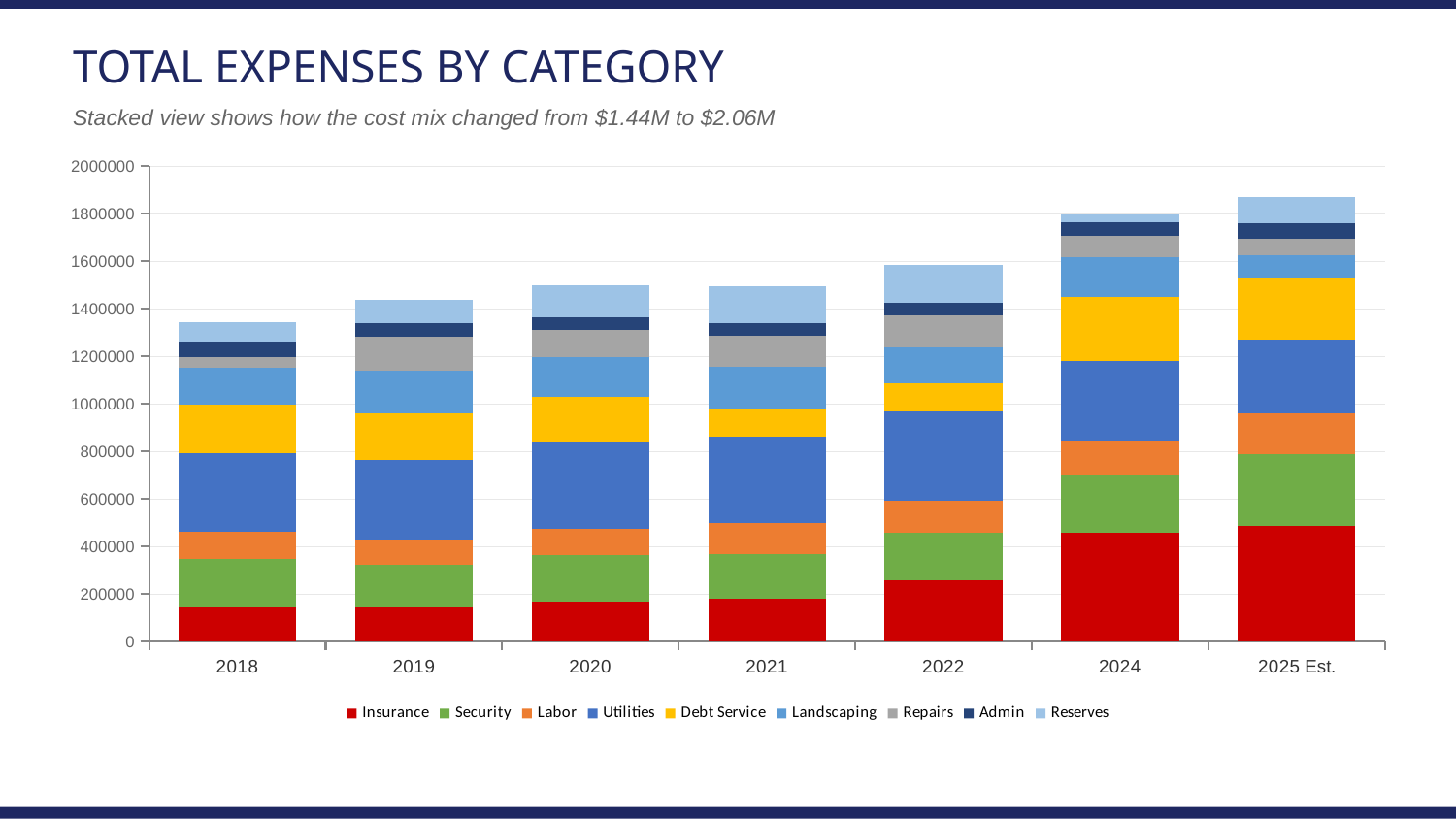
How many series does the legend list? 9 What is the title of the chart? TOTAL EXPENSES BY CATEGORY Which year has the lowest total expenses? 2018 How many year categories are shown on the x axis? 7 Is the total expenses bar for 2018 greater or less than 1400000? less What kind of chart is shown on the slide? Stacked bar chart Is the total expenses bar for 2025 Est. greater or less than 1800000? greater Which series is shown in red in the legend? Insurance Which year has a larger total expenses bar, 2021 or 2024? 2024 Is the total expenses bar for 2022 greater or less than 1400000? greater Which year has the highest total expenses? 2025 Est. Do total expenses generally rise or fall from 2018 to 2025 Est.? Rise